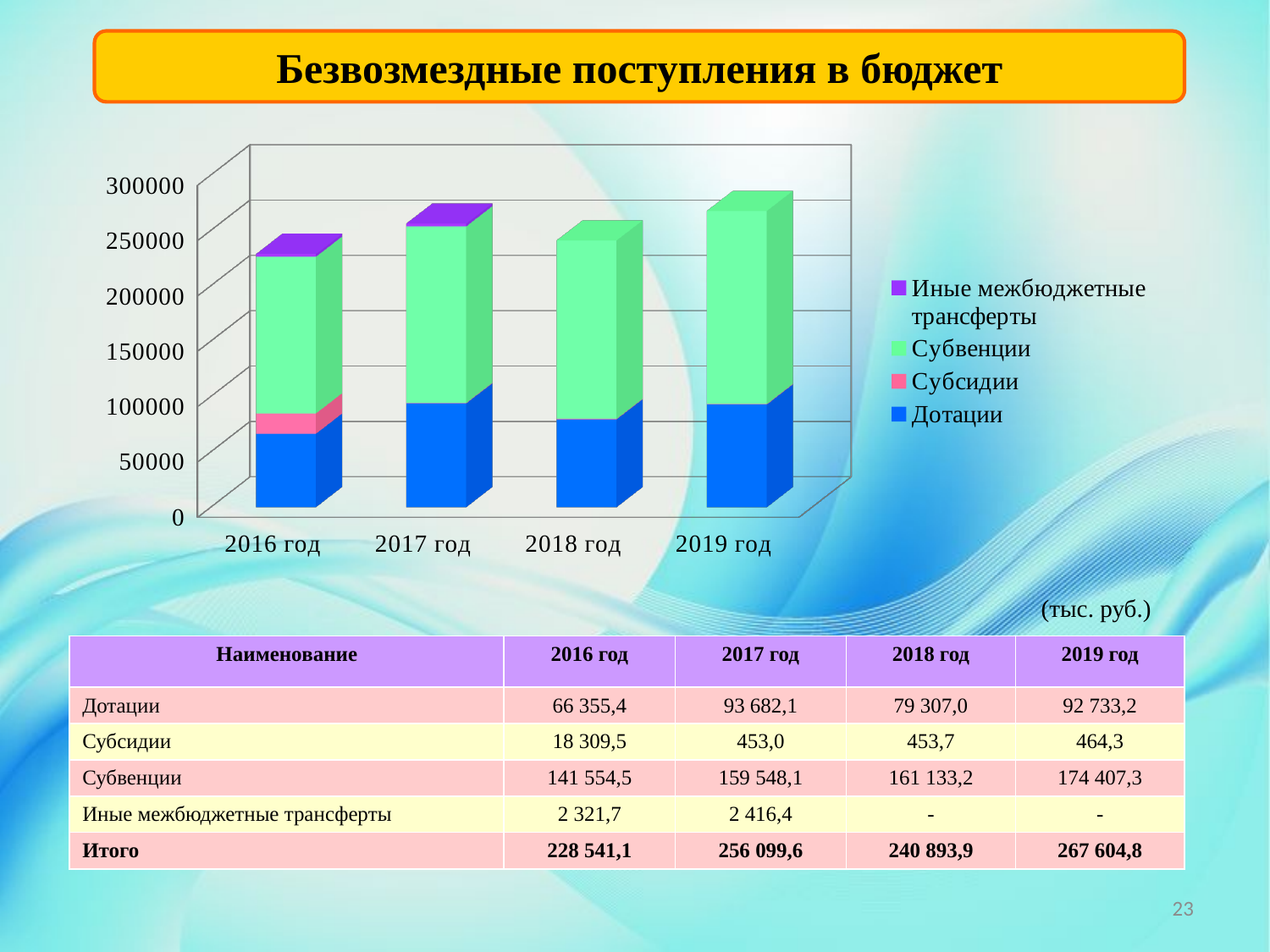
What is the total (Итого) of the stacked bar for 2018 год? 240 893,9 By how much did Субвенции increase from 2016 год to 2019 год? 32 852,8 Which colour represents Субсидии in the chart legend? pink How many years are shown along the x axis of the chart? 4 What is the value of Субвенции for 2019 год? 174 407,3 Is the total stacked bar for 2019 год greater or less than 250000? greater Which year has the larger value of Дотации, 2017 год or 2018 год? 2017 год Which year has the lowest total of безвозмездные поступления? 2016 год How many series does the chart legend list? 4 Which year has the highest total of безвозмездные поступления? 2019 год What type of chart is shown on the slide? bar chart What is the value of Дотации for 2017 год? 93 682,1